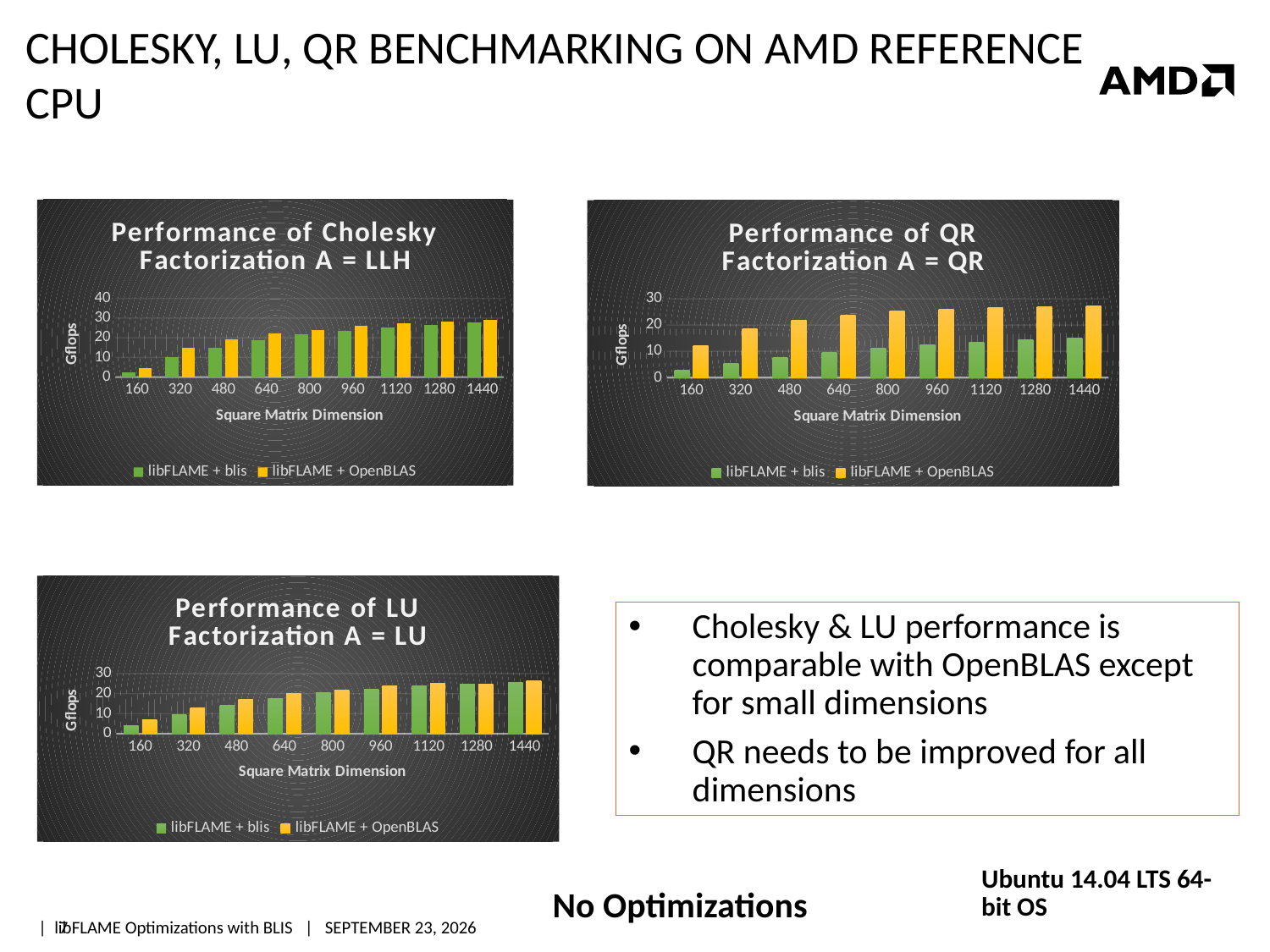
In the 'Performance of Cholesky Factorization A = LLH' chart, is the value for libFLAME + OpenBLAS at dimension 1440 greater or less than 20? greater What is the y-axis label of the 'Performance of LU Factorization A = LU' chart? Gflops In the 'Performance of QR Factorization A = QR' chart, is the value for libFLAME + blis at dimension 1440 greater or less than 20? less In the 'Performance of QR Factorization A = QR' chart, at which square matrix dimension is the libFLAME + blis value lowest? 160 What kind of chart is the 'Performance of Cholesky Factorization A = LLH' chart? bar chart How many series does the legend of the 'Performance of QR Factorization A = QR' chart list? 2 In the 'Performance of LU Factorization A = LU' chart, is the value for libFLAME + blis at dimension 160 greater or less than 10? less In the 'Performance of QR Factorization A = QR' chart, which series has the larger value at dimension 1440? libFLAME + OpenBLAS How many square matrix dimensions are shown on the x axis of the 'Performance of LU Factorization A = LU' chart? 9 In the 'Performance of Cholesky Factorization A = LLH' chart, which series has the larger value at dimension 320? libFLAME + OpenBLAS In the 'Performance of LU Factorization A = LU' chart, do the libFLAME + blis values rise or fall as the square matrix dimension increases? rise